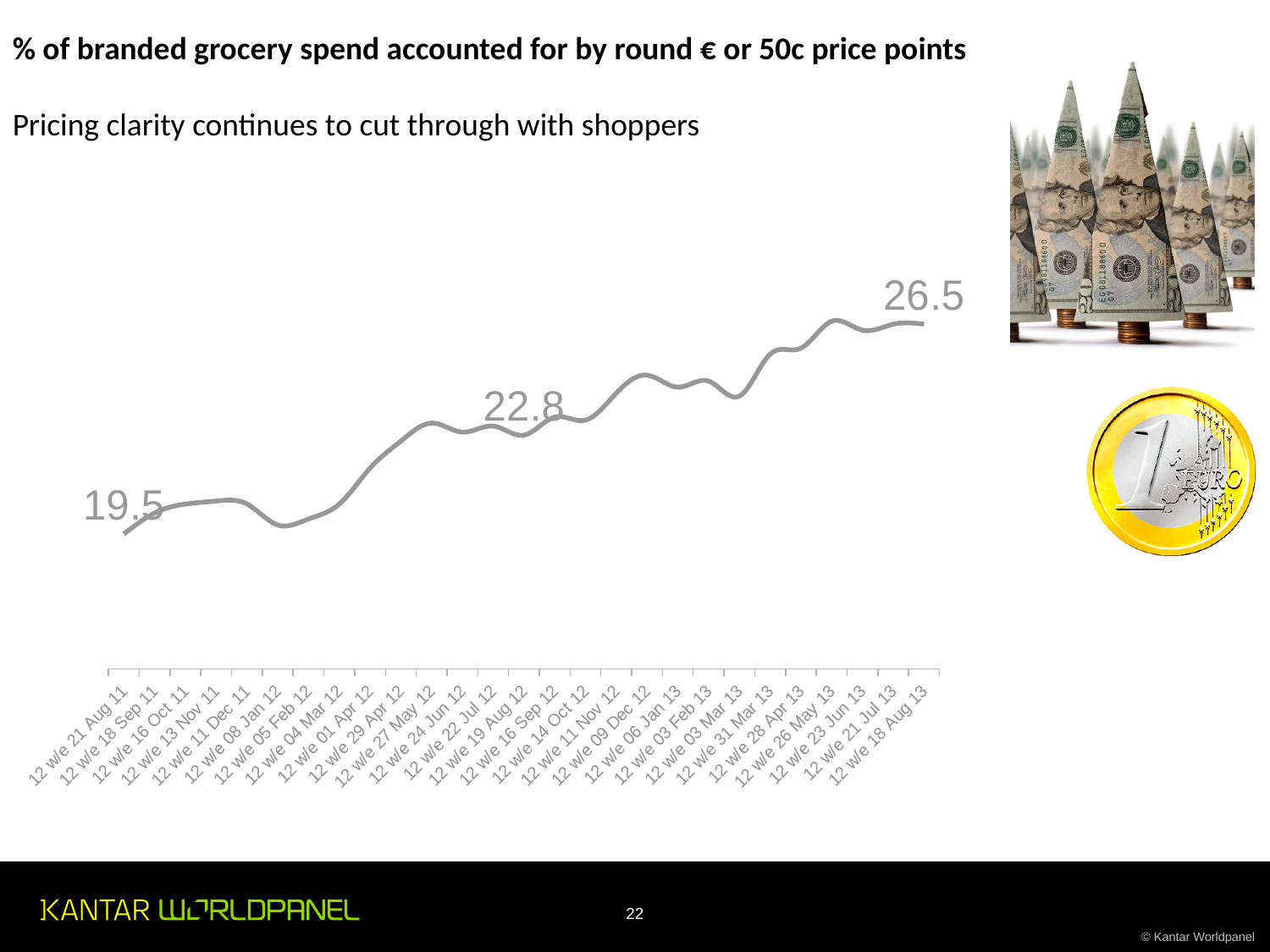
What is the difference between the value for 12 w/e 18 Aug 13 and the value for 12 w/e 21 Aug 11? 7 Which is larger, the value for 12 w/e 19 Aug 12 or the value for 12 w/e 18 Aug 13? 12 w/e 18 Aug 13 What kind of chart is shown on the slide? line chart What is the value for 12 w/e 21 Aug 11? 19.5 What is the title of the chart? % of branded grocery spend accounted for by round € or 50c price points What is the value for 12 w/e 19 Aug 12? 22.8 What is the difference between the value for 12 w/e 18 Aug 13 and the value for 12 w/e 19 Aug 12? 3.7 How many periods are labelled on the x axis? 27 Do the values generally rise or fall along the x axis? rise What is the difference between the value for 12 w/e 19 Aug 12 and the value for 12 w/e 21 Aug 11? 3.3 Which is larger, the value for 12 w/e 21 Aug 11 or the value for 12 w/e 18 Aug 13? 12 w/e 18 Aug 13 What is the value for 12 w/e 18 Aug 13? 26.5